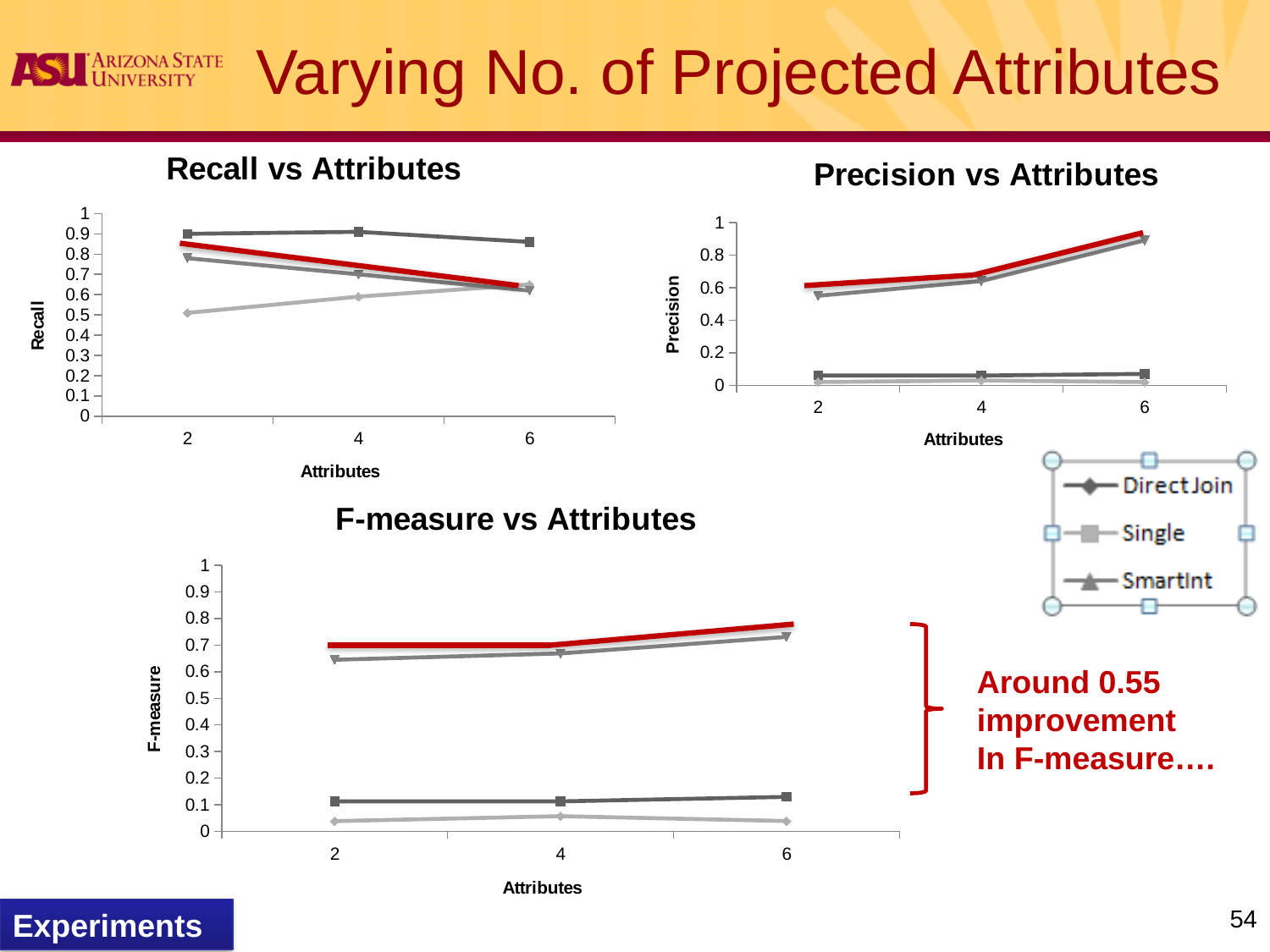
In the "Precision vs Attributes" chart, does the SmartInt line rise or fall as the number of attributes increases from 2 to 6? rise In the "F-measure vs Attributes" chart, which is larger at 6 attributes, SmartInt or Single? SmartInt In the "Recall vs Attributes" chart, is the value for DirectJoin at 2 attributes greater or less than 0.6? less In the "Recall vs Attributes" chart, which series has the highest recall at 2 attributes? Single What are the three series named in the legend? DirectJoin, Single, SmartInt In the "F-measure vs Attributes" chart, how many attribute values are plotted along the x axis? 3 In the "Precision vs Attributes" chart, is the value for SmartInt at 6 attributes greater or less than 0.8? greater In the "Recall vs Attributes" chart, is the value for Single at 2 attributes greater or less than 0.8? greater In the "Recall vs Attributes" chart, does the SmartInt line rise or fall as the number of attributes increases from 2 to 6? fall What kind of chart is the "Recall vs Attributes" chart? line chart How many series does the legend list for the charts on this slide? 3